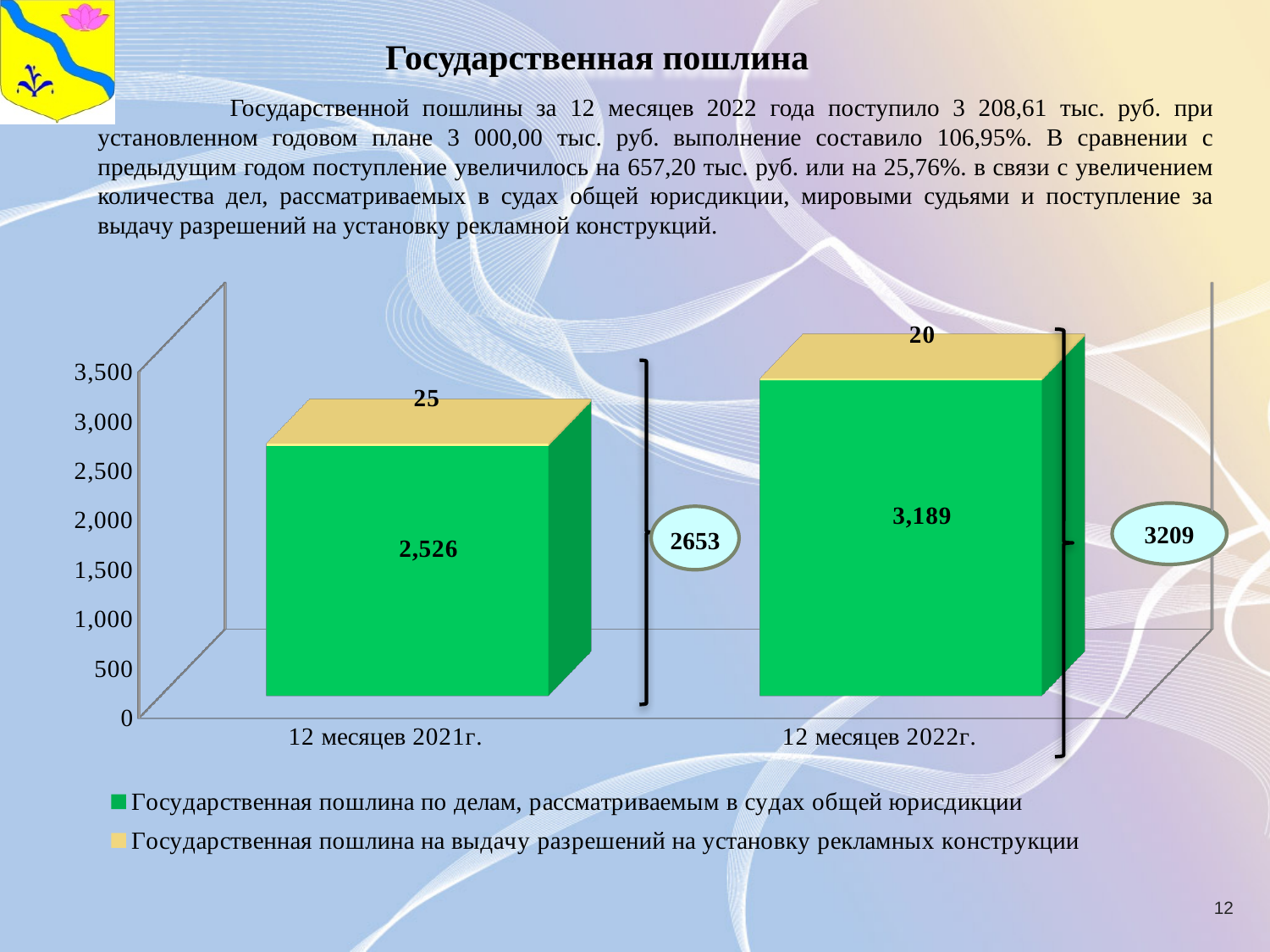
By how much did 'Государственная пошлина по делам, рассматриваемым в судах общей юрисдикции' change from 12 месяцев 2021г. to 12 месяцев 2022г.? 663 What is the value of 'Государственная пошлина по делам, рассматриваемым в судах общей юрисдикции' for 12 месяцев 2021г.? 2,526 How many categories are shown on the x axis of the chart? 2 Which period has the larger value for 'Государственная пошлина по делам, рассматриваемым в судах общей юрисдикции', 12 месяцев 2021г. or 12 месяцев 2022г.? 12 месяцев 2022г. What kind of chart is shown on the slide? bar chart What is the difference between the 2021 and 2022 values of 'Государственная пошлина на выдачу разрешений на установку рекламных конструкции'? 5 What is the total of the stacked bar for 12 месяцев 2022г.? 3209 What is the value of 'Государственная пошлина на выдачу разрешений на установку рекламных конструкции' for 12 месяцев 2021г.? 25 What is the value of 'Государственная пошлина по делам, рассматриваемым в судах общей юрисдикции' for 12 месяцев 2022г.? 3,189 Does the value of 'Государственная пошлина по делам, рассматриваемым в судах общей юрисдикции' rise or fall from 12 месяцев 2021г. to 12 месяцев 2022г.? rise What is the value of 'Государственная пошлина на выдачу разрешений на установку рекламных конструкции' for 12 месяцев 2022г.? 20 How many series does the chart legend list? 2